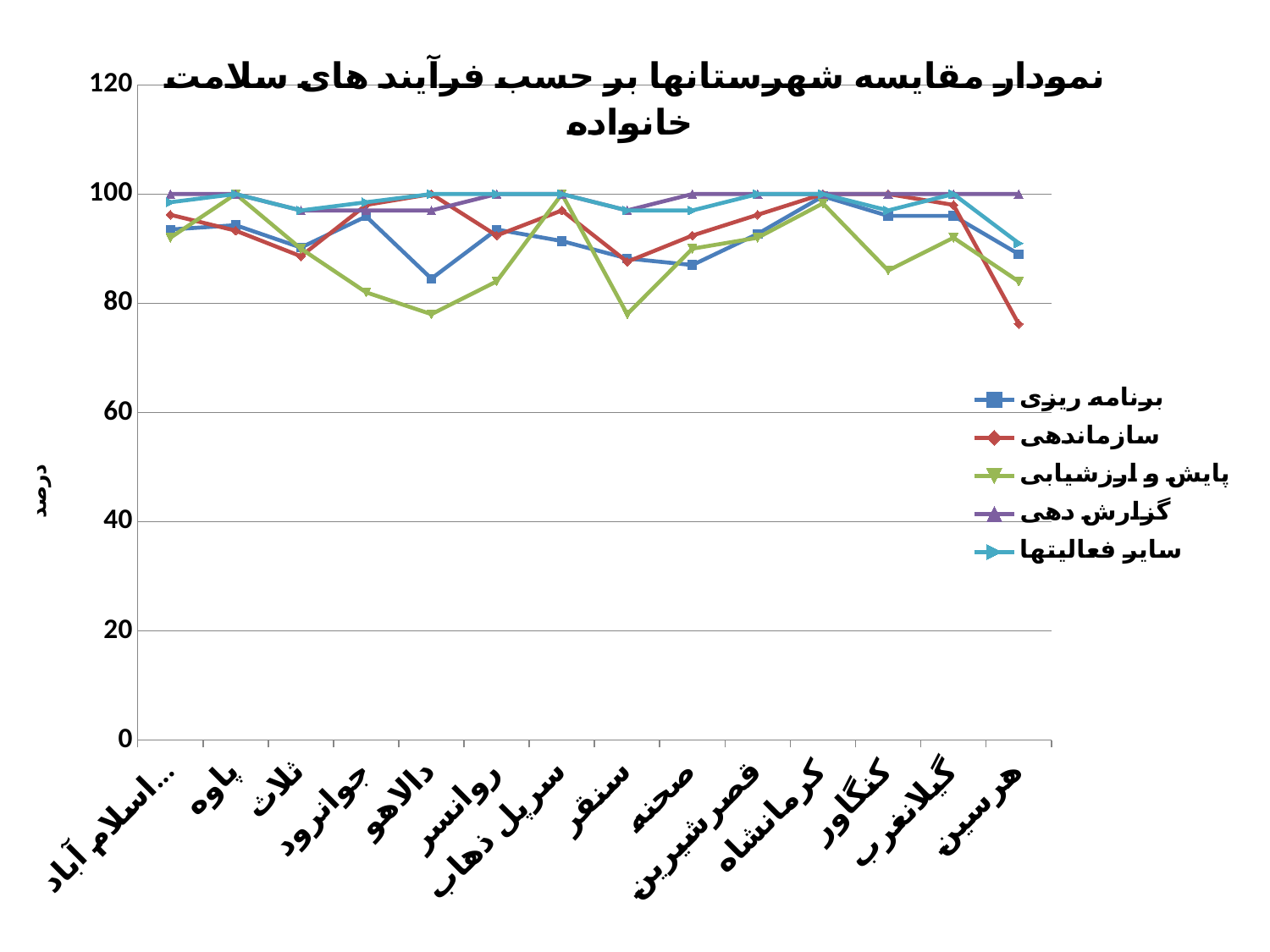
What kind of chart is shown on the slide? line chart For the سازماندهی series, which city has the lowest value? هرسین Is the value for گزارش دهی at هرسین greater or less than 80? greater Is the value for سازماندهی at هرسین greater or less than 80? less Is the value for برنامه ریزی at دالاهو greater or less than 80? greater How many series does the legend list? 5 What is the title of the chart? نمودار مقایسه شهرستانها بر حسب فرآیند های سلامت خانواده At هرسین, which series has the larger value: گزارش دهی or سازماندهی? گزارش دهی What is the label on the vertical axis? درصد At دالاهو, which series has the larger value: برنامه ریزی or پایش و ارزشیابی? برنامه ریزی How many categories (cities) are shown along the x axis? 14